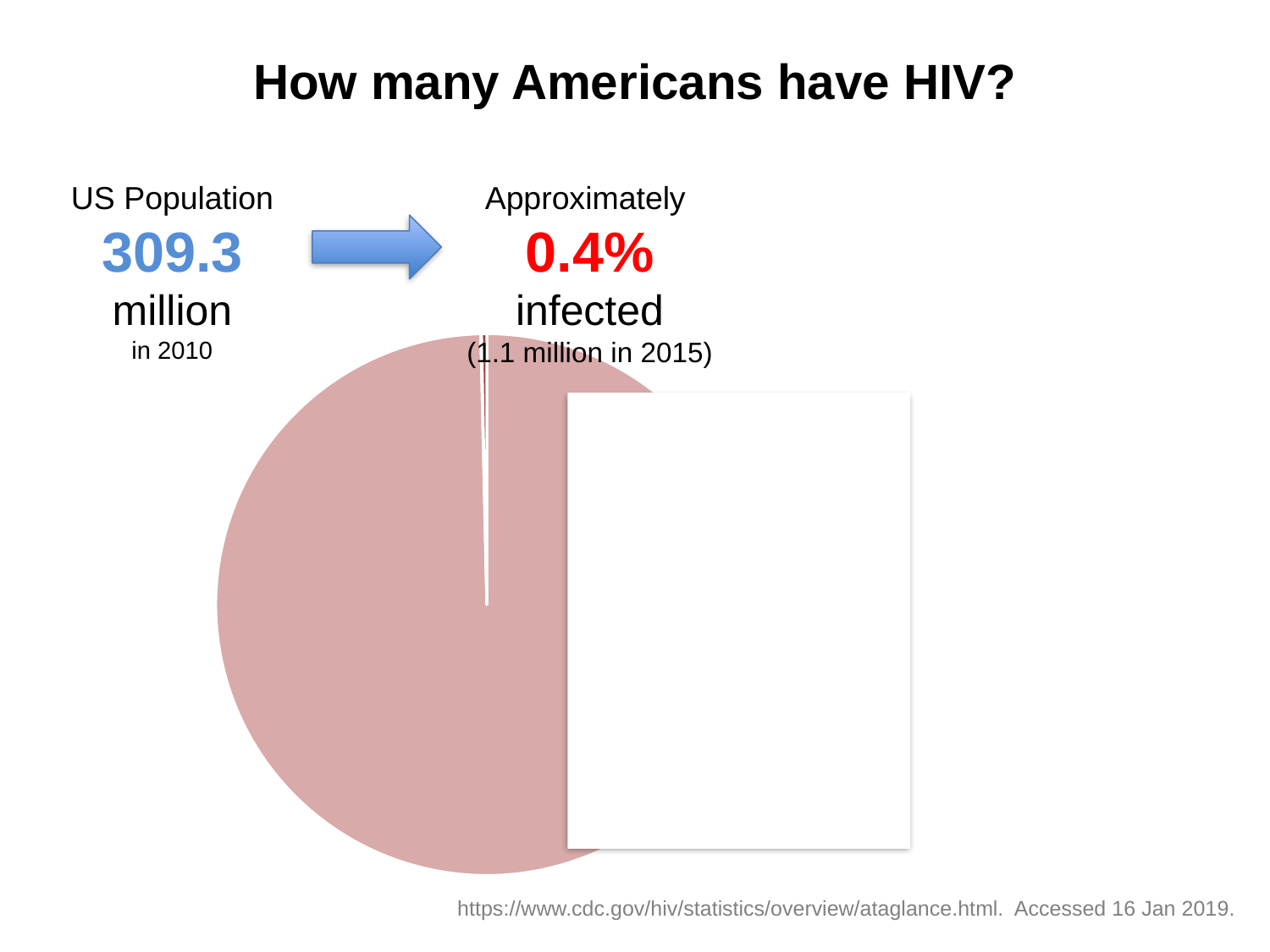
According to the slide, how many Americans were infected with HIV in 2015? 1.1 million How many slices does the pie chart have? 2 According to the slide, what was the US population in 2010 that the pie chart represents? 309.3 million What share of the pie does the slice representing Americans infected with HIV take up? 0.4% What kind of chart is shown on the slide? pie chart What colour is the large slice of the pie chart? pink Is the slice representing infected Americans larger or smaller than the slice representing the rest of the US population? smaller What is the title of the slide containing the pie chart? How many Americans have HIV?